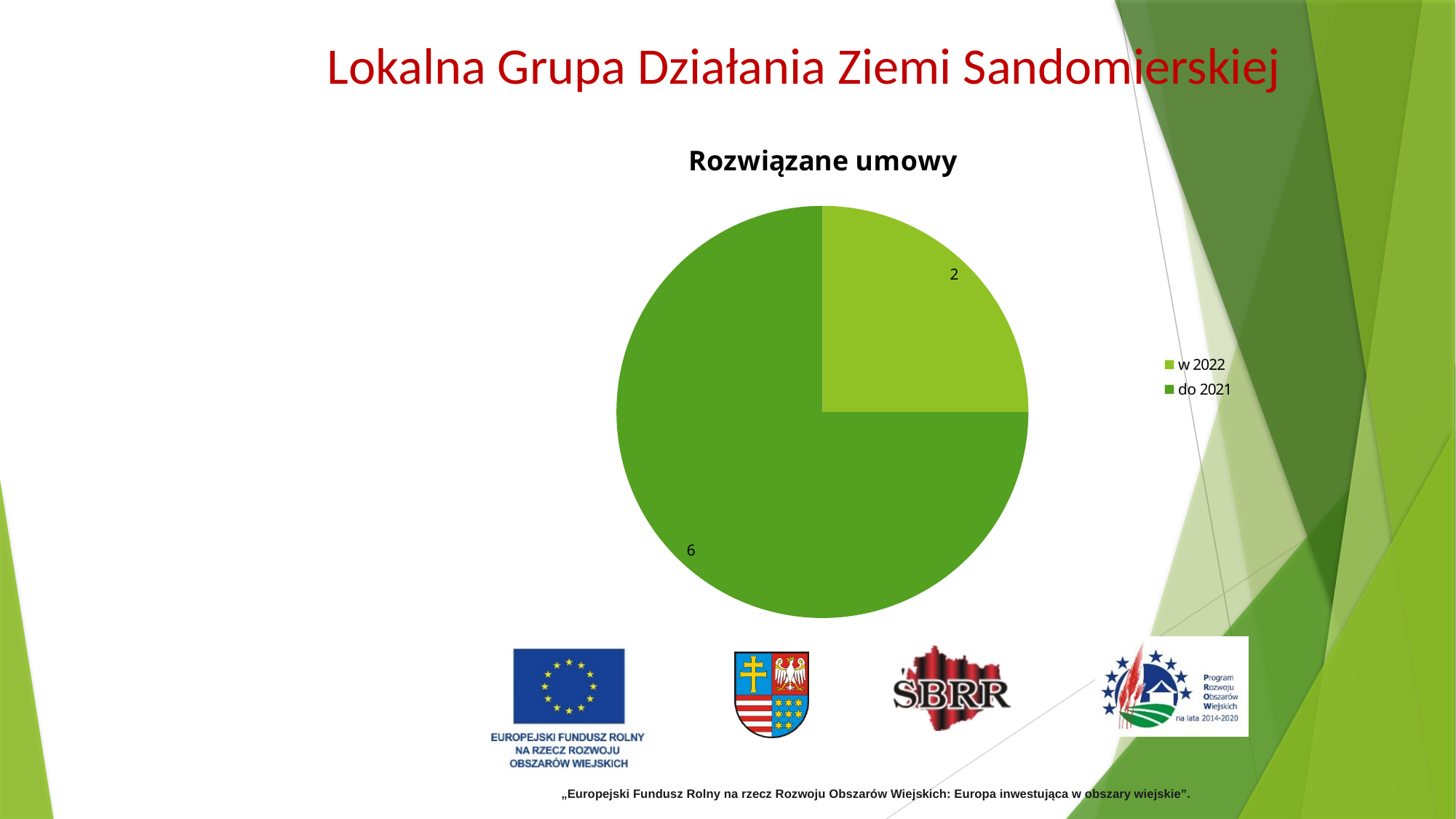
How many slices does the pie chart have? 2 How many entries does the legend list? 2 What is the total of all slices in the pie chart? 8 What is the value for "do 2021"? 6 What is the title of the chart? Rozwiązane umowy Which category has the largest slice of the pie? do 2021 Which is larger, the value for "w 2022" or the value for "do 2021"? do 2021 What type of chart is shown on the slide? pie chart What share of the pie does the "w 2022" slice represent? 25% Which category has the smallest slice of the pie? w 2022 What is the difference between the values for "do 2021" and "w 2022"? 4 What is the value for "w 2022"? 2